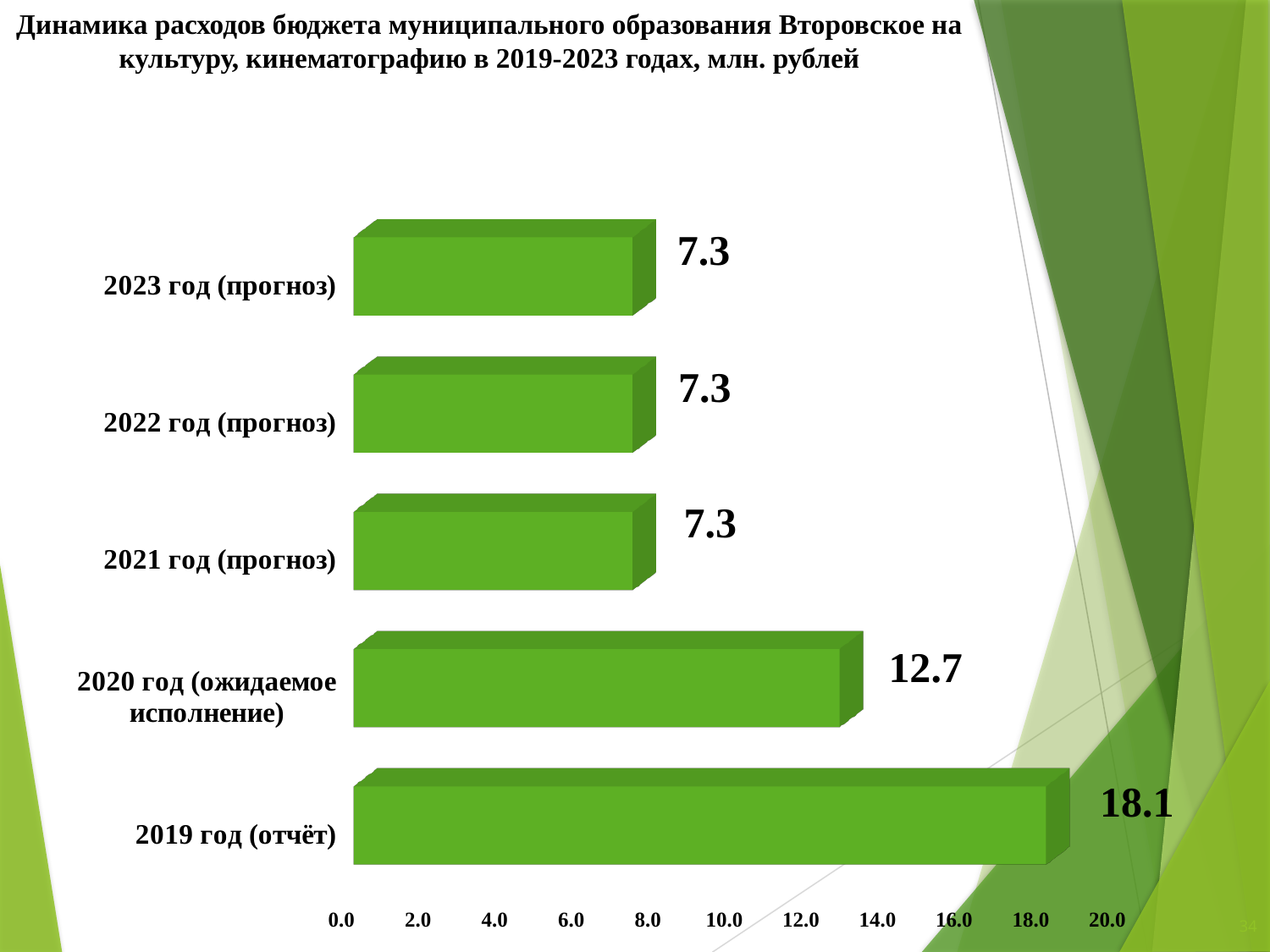
What is the value for 2020 год (ожидаемое исполнение)? 12.7 What is the difference between the values for 2019 год (отчёт) and 2020 год (ожидаемое исполнение)? 5.4 What is the difference between the values for 2020 год (ожидаемое исполнение) and 2022 год (прогноз)? 5.4 What is the value for 2019 год (отчёт)? 18.1 Which is larger, the value for 2019 год (отчёт) or the value for 2020 год (ожидаемое исполнение)? 2019 год (отчёт) Which category has the highest value? 2019 год (отчёт) What is the value for 2021 год (прогноз)? 7.3 What is the highest tick value shown on the horizontal axis? 20.0 Is the value for 2020 год (ожидаемое исполнение) greater or less than 10.0? greater What kind of chart is shown on the slide? bar chart How many categories are shown in the chart? 5 What is the value for 2023 год (прогноз)? 7.3